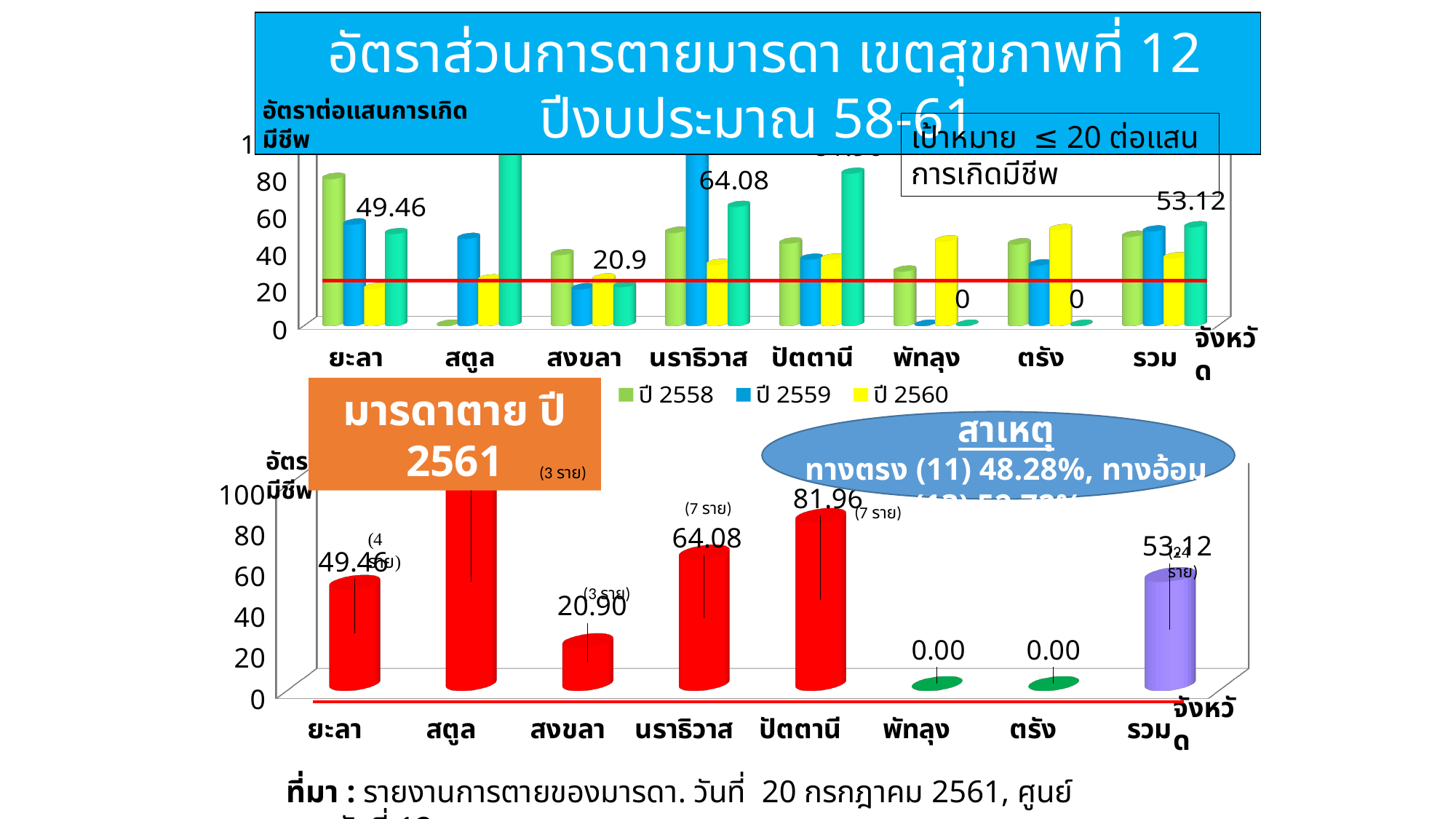
In the bottom chart (มารดาตาย ปี 2561), what is the value for สงขลา? 20.90 In the bottom chart (มารดาตาย ปี 2561), which province has the tallest bar? สตูล In the bottom chart (มารดาตาย ปี 2561), what is the difference between the values for ปัตตานี and นราธิวาส? 17.88 In the top chart, is the value for ปี 2558 in ยะลา greater or less than 60? greater In the bottom chart (มารดาตาย ปี 2561), what is the value for ปัตตานี? 81.96 In the bottom chart (มารดาตาย ปี 2561), which is larger, the value for นราธิวาส or the value for ยะลา? นราธิวาส What kind of chart is the bottom chart (มารดาตาย ปี 2561)? bar chart In the bottom chart (มารดาตาย ปี 2561), what is the value for รวม? 53.12 In the bottom chart (มารดาตาย ปี 2561), what is the value for ยะลา? 49.46 In the top chart, how many series does the visible legend list? 3 In the bottom chart (มารดาตาย ปี 2561), how many categories are shown on the x axis? 8 In the bottom chart (มารดาตาย ปี 2561), what is the difference between the values for ยะลา and สงขลา? 28.56